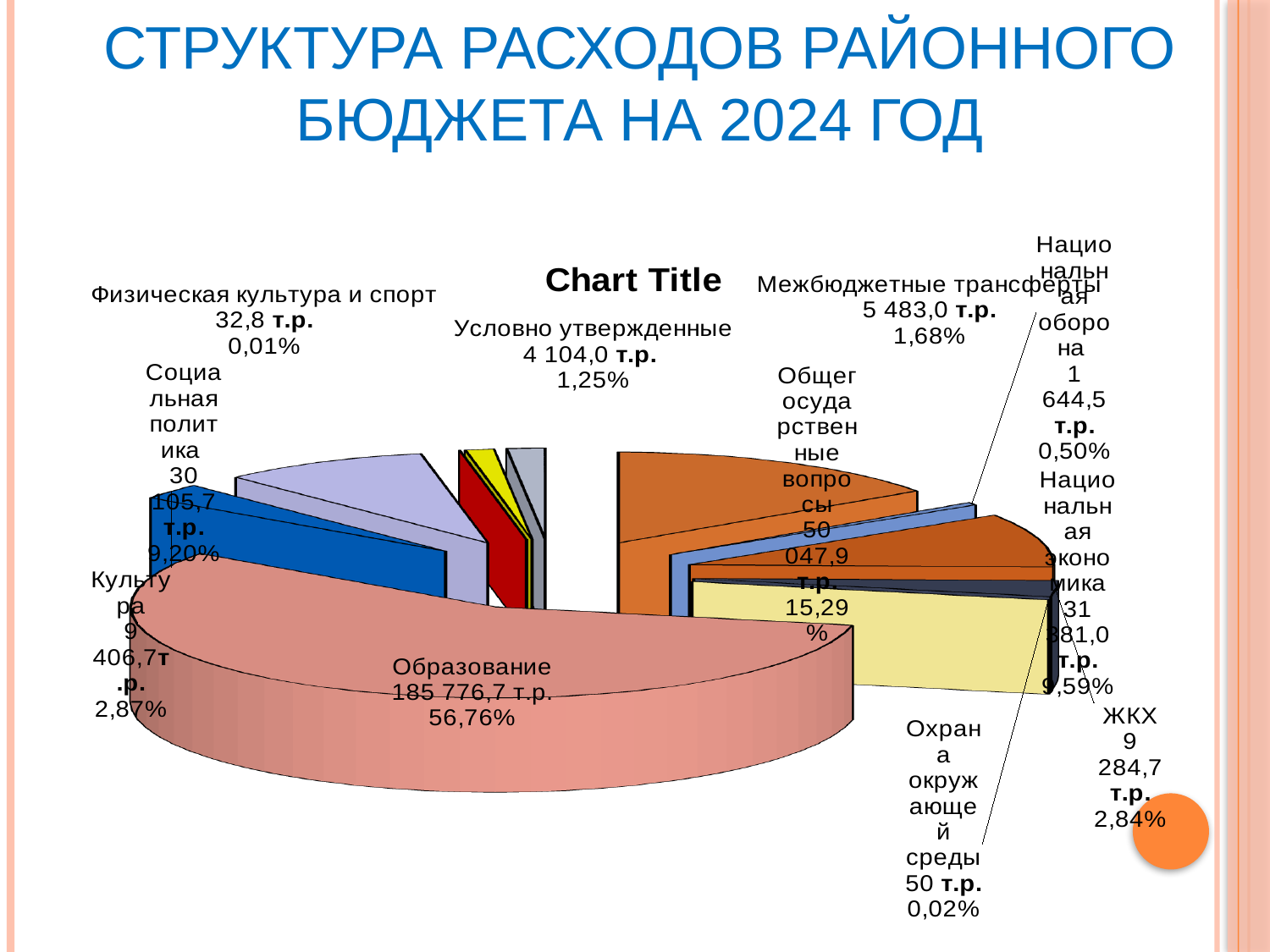
What is the difference between the values for Межбюджетные трансферты and Условно утвержденные? 1 379,0 т.р. What is the value shown for Межбюджетные трансферты? 5 483,0 т.р. Which is larger: the share for Общегосударственные вопросы or the share for Национальная экономика? Общегосударственные вопросы Which category has the largest share of the pie? Образование What percentage is shown for Условно утвержденные? 1,25% Which category has the smallest share of the pie? Физическая культура и спорт What percentage is shown for ЖКХ? 2,84% What percentage is shown for Общегосударственные вопросы? 15,29% How many categories are shown in the pie chart? 11 What kind of chart is shown on the slide? Pie chart What is the value shown for Образование? 185 776,7 т.р. What share of the budget expenditure does Образование account for? 56,76%